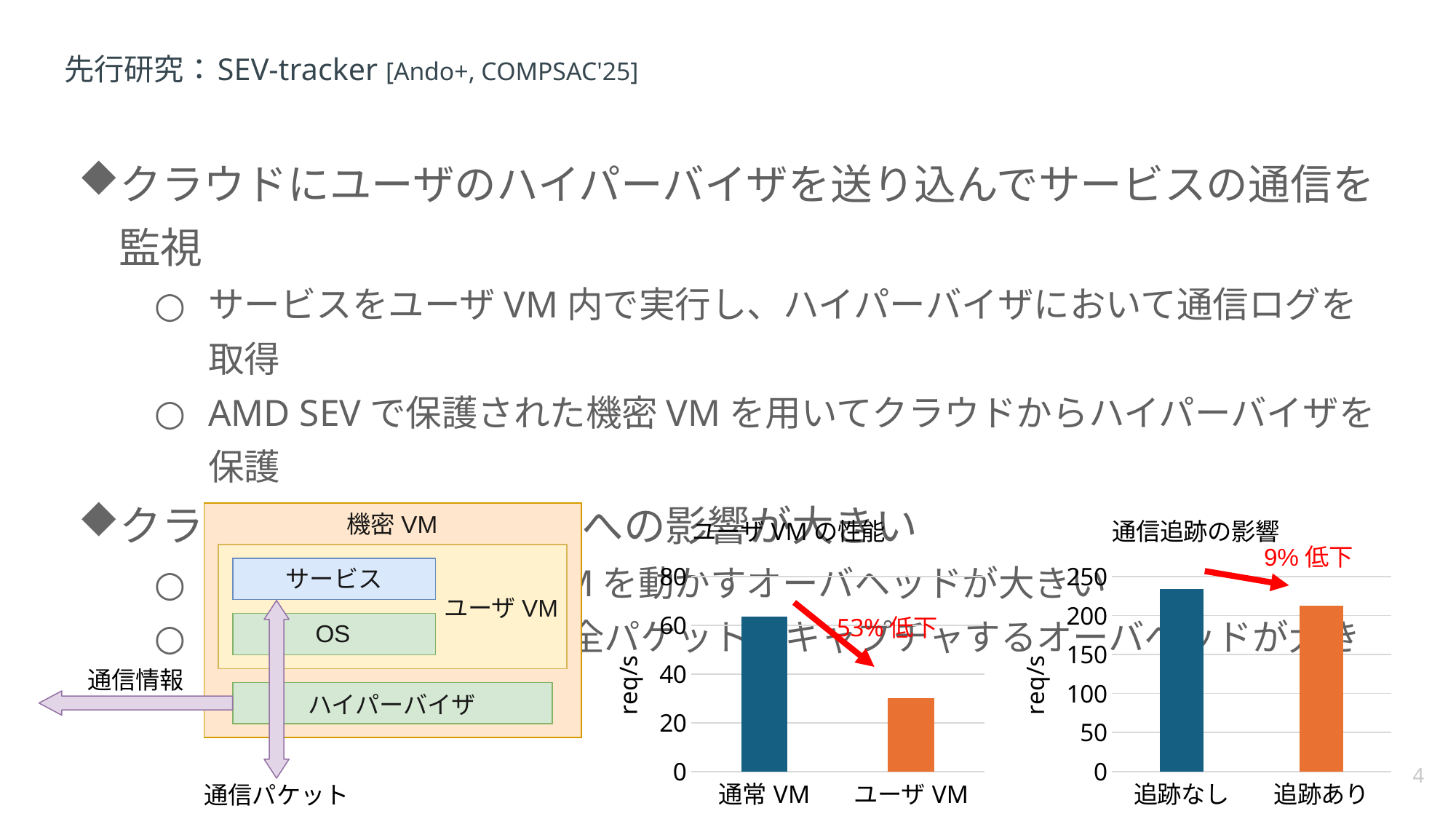
In the chart titled ユーザ VM の性能, which category has the lowest value? ユーザ VM In the chart titled 通信追跡の影響, is the value for 追跡なし greater or less than 200? greater In the chart titled ユーザ VM の性能, how many categories are plotted? 2 In the chart titled 通信追跡の影響, how many bars are plotted? 2 In the chart titled ユーザ VM の性能, what percentage decrease is annotated on the chart? 53% 低下 In the chart titled ユーザ VM の性能, is the value for 通常 VM greater or less than 60? greater In the chart titled 通信追跡の影響, which category has the higher value, 追跡なし or 追跡あり? 追跡なし In the chart titled ユーザ VM の性能, what kind of chart is shown? bar chart In the chart titled ユーザ VM の性能, is the value for ユーザ VM greater or less than 40? less In the chart titled ユーザ VM の性能, which category has the highest value? 通常 VM In the chart titled 通信追跡の影響, what is the y-axis label? req/s